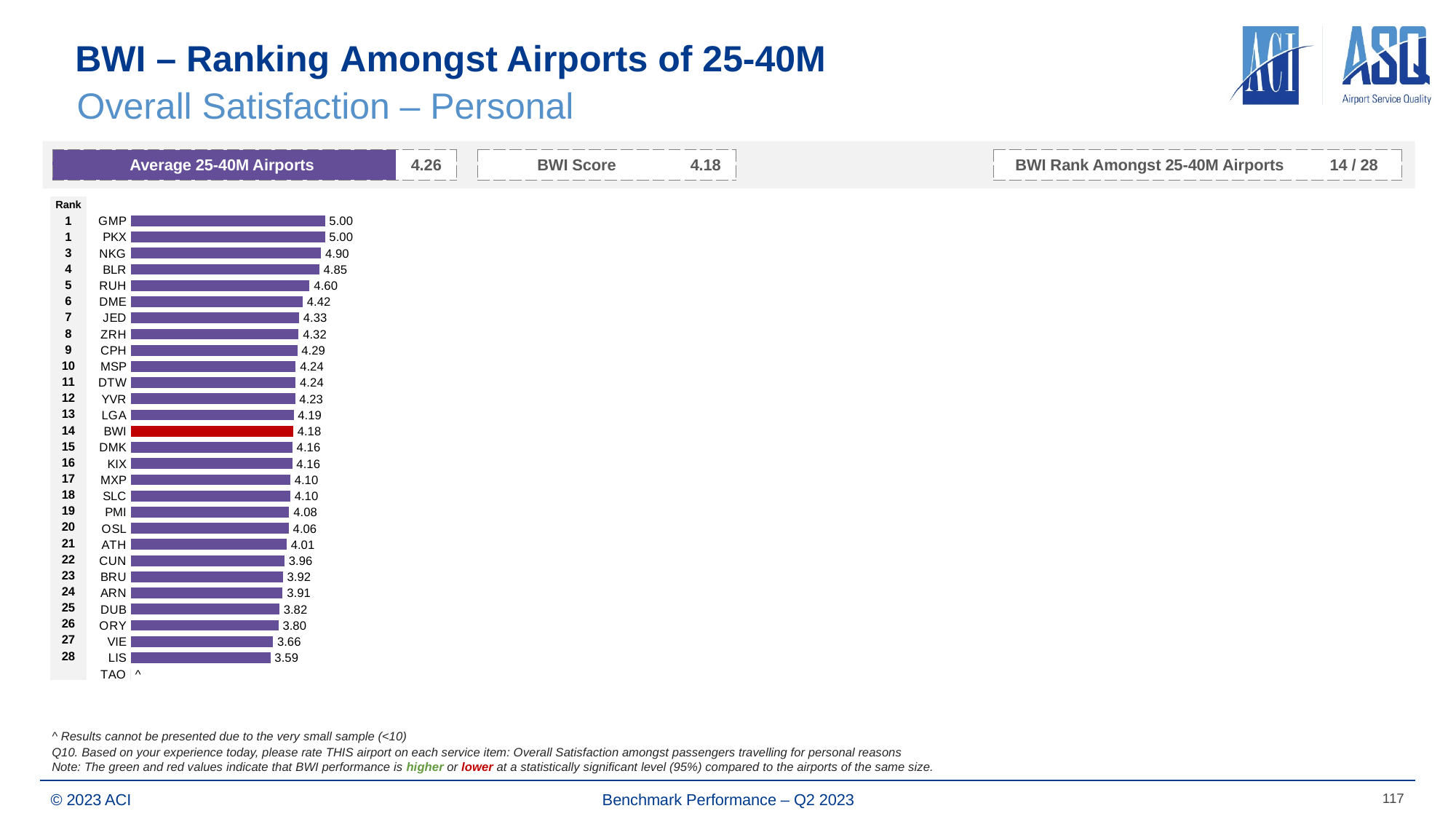
Which has a larger value, RUH or DME? RUH How many airports have a ranked bar plotted on the chart? 28 Which airport has the lowest value on the chart? LIS What is the highest value shown on the chart? 5.00 What is the value shown for DUB on the chart? 3.82 What colour is the bar for BWI? Red What is the value shown for BWI on the chart? 4.18 What kind of chart is shown on the slide? Bar chart Which has a larger value, VIE or CUN? CUN What is the difference between the Average 25-40M Airports score and the BWI Score? 0.08 What is the difference between the value for GMP and the value for LIS? 1.41 What is the value shown for ZRH on the chart? 4.32